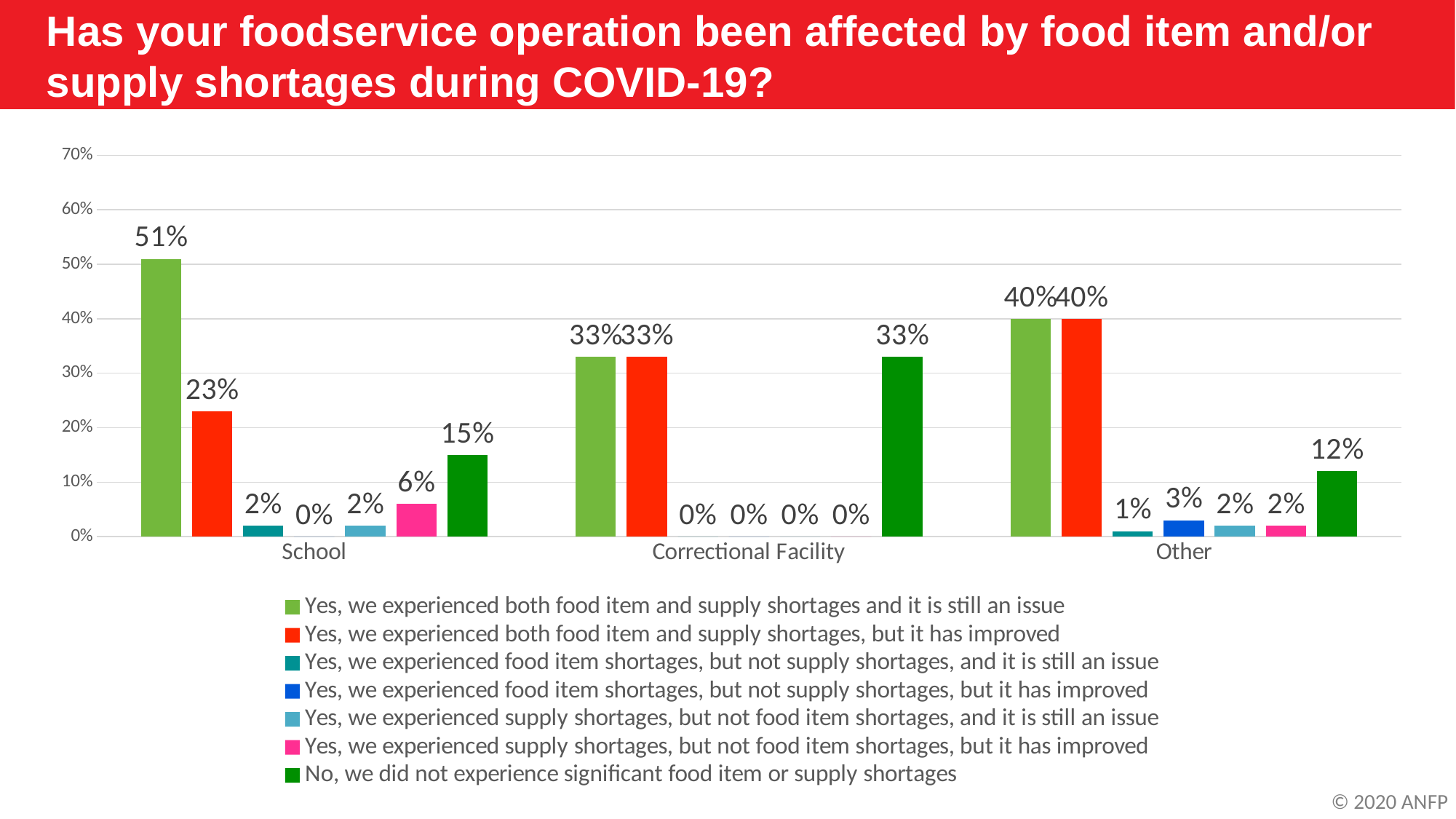
What is the difference between the School values for 'both shortages and it is still an issue' and 'both shortages, but it has improved'? 28% How many series does the legend list? 7 What percentage of School respondents said they experienced supply shortages, but not food item shortages, but it has improved? 6% What kind of chart is shown on the slide? Bar chart What percentage of School respondents said they experienced both food item and supply shortages and it is still an issue? 51% Which is larger for School: 'No, we did not experience significant food item or supply shortages' or 'Yes, we experienced supply shortages, but not food item shortages, but it has improved'? No, we did not experience significant food item or supply shortages What colour represents 'No, we did not experience significant food item or supply shortages'? Dark green Which category has the highest value for 'Yes, we experienced both food item and supply shortages and it is still an issue'? School What percentage of Other respondents said they did not experience significant food item or supply shortages? 12% How many categories are shown on the x axis? 3 What percentage of Correctional Facility respondents said they experienced both food item and supply shortages, but it has improved? 33% Which category has the lowest value for 'No, we did not experience significant food item or supply shortages'? Other